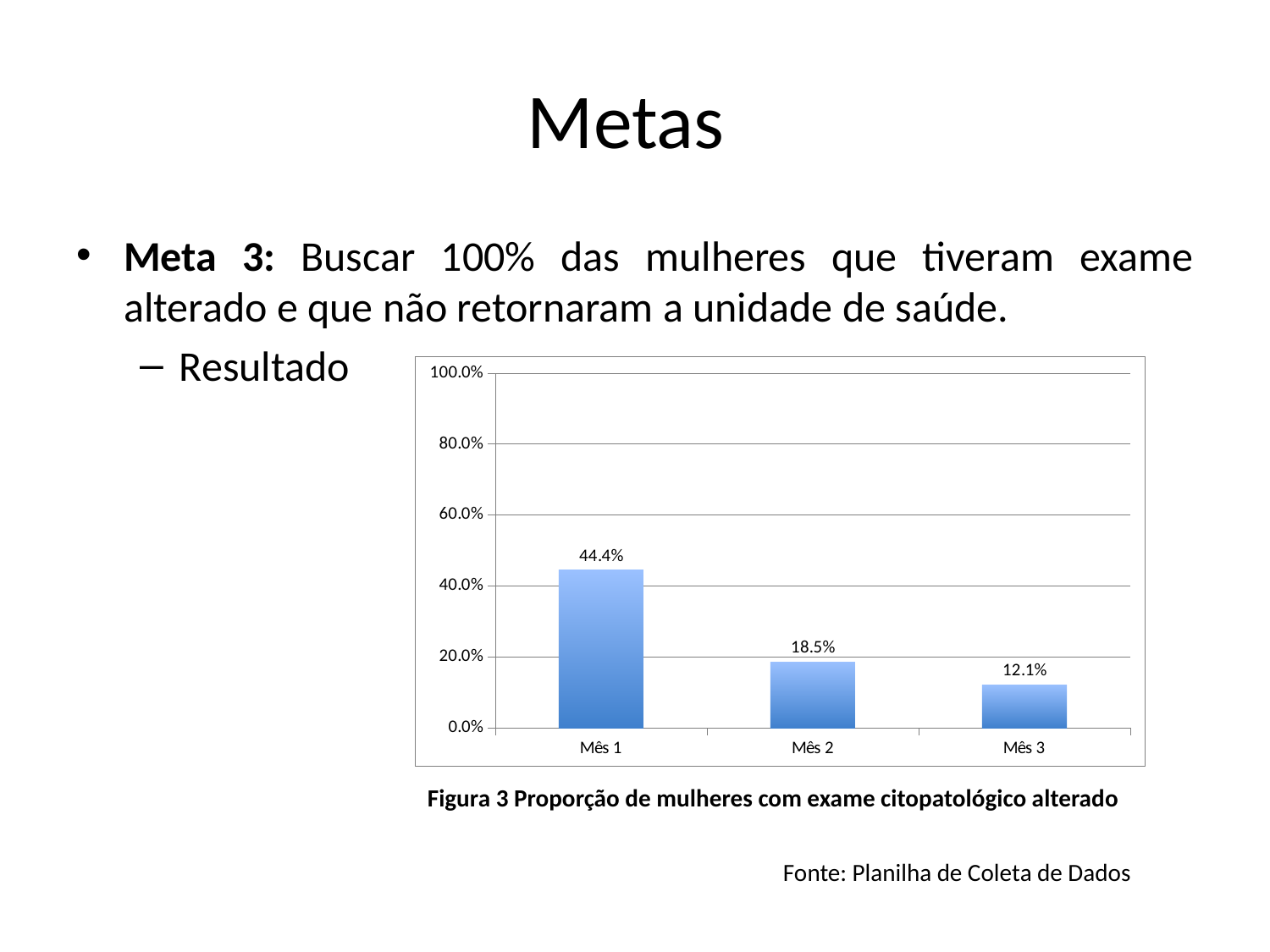
Which month has the lowest value? Mês 3 What is the difference between the values for Mês 1 and Mês 2? 25.9% Do the values rise or fall from Mês 1 to Mês 3? fall Which is larger, the value for Mês 2 or the value for Mês 3? Mês 2 Which month has the highest value? Mês 1 What kind of chart is shown on the slide? bar chart How many months are shown on the x axis? 3 What is the value for Mês 3? 12.1% What is the difference between the values for Mês 2 and Mês 3? 6.4% Is the value for Mês 1 greater or less than 40.0%? greater What is the value for Mês 2? 18.5% What is the value for Mês 1? 44.4%